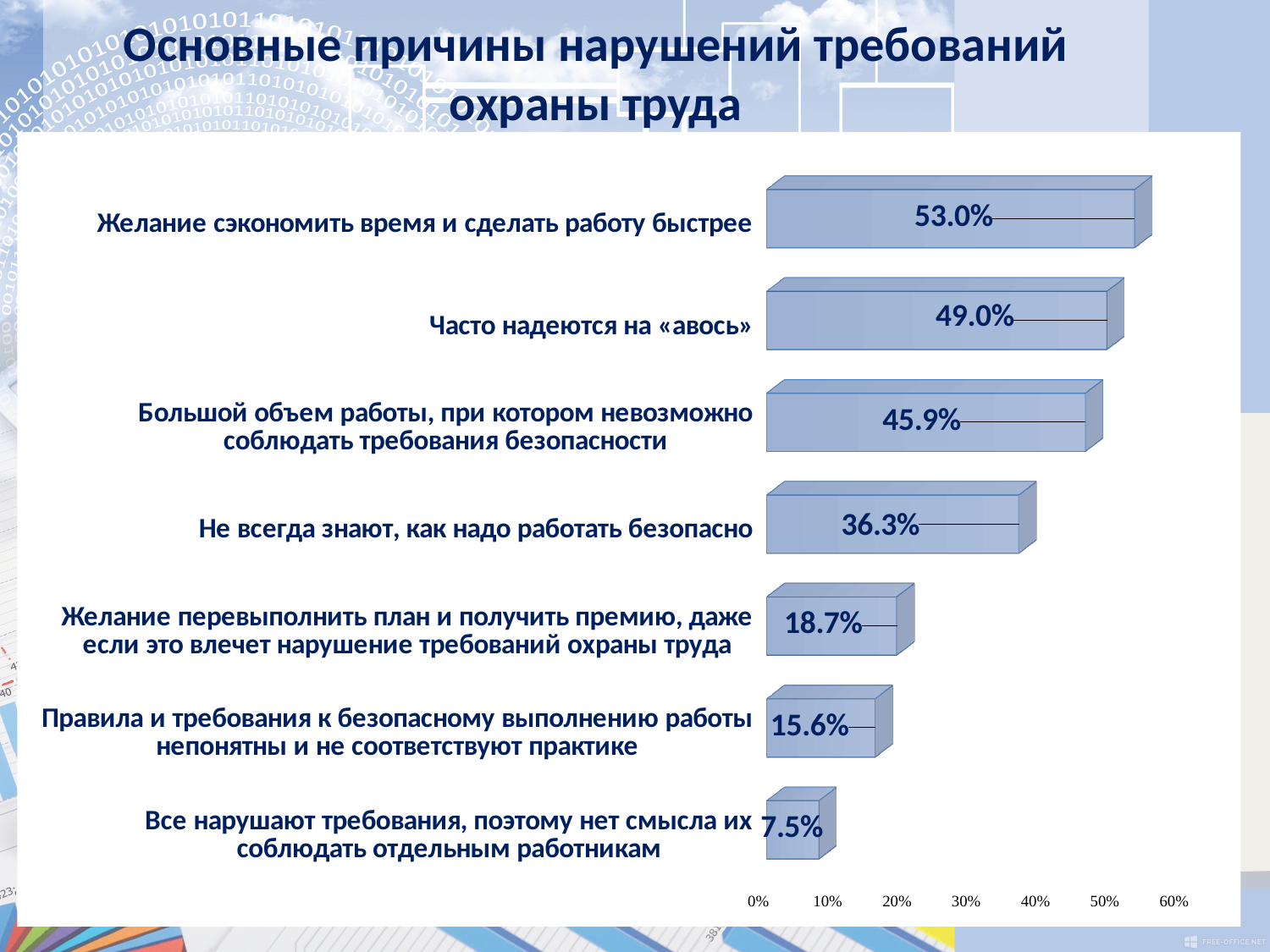
How many categories are shown in the chart? 7 What is the value for «Не всегда знают, как надо работать безопасно»? 36.3% What kind of chart is shown on the slide? bar chart Is the value for «Большой объем работы, при котором невозможно соблюдать требования безопасности» greater or less than 40%? greater What is the maximum value shown on the horizontal axis? 60% What is the difference between the values for «Желание сэкономить время и сделать работу быстрее» and «Часто надеются на «авось»»? 4.0% What is the title of the slide? Основные причины нарушений требований охраны труда What is the value for «Часто надеются на «авось»»? 49.0% What is the value for «Желание перевыполнить план и получить премию, даже если это влечет нарушение требований охраны труда»? 18.7% Which category has the highest value? Желание сэкономить время и сделать работу быстрее Which category has the lowest value? Все нарушают требования, поэтому нет смысла их соблюдать отдельным работникам Which is larger: the value for «Не всегда знают, как надо работать безопасно» or the value for «Правила и требования к безопасному выполнению работы непонятны и не соответствуют практике»? Не всегда знают, как надо работать безопасно